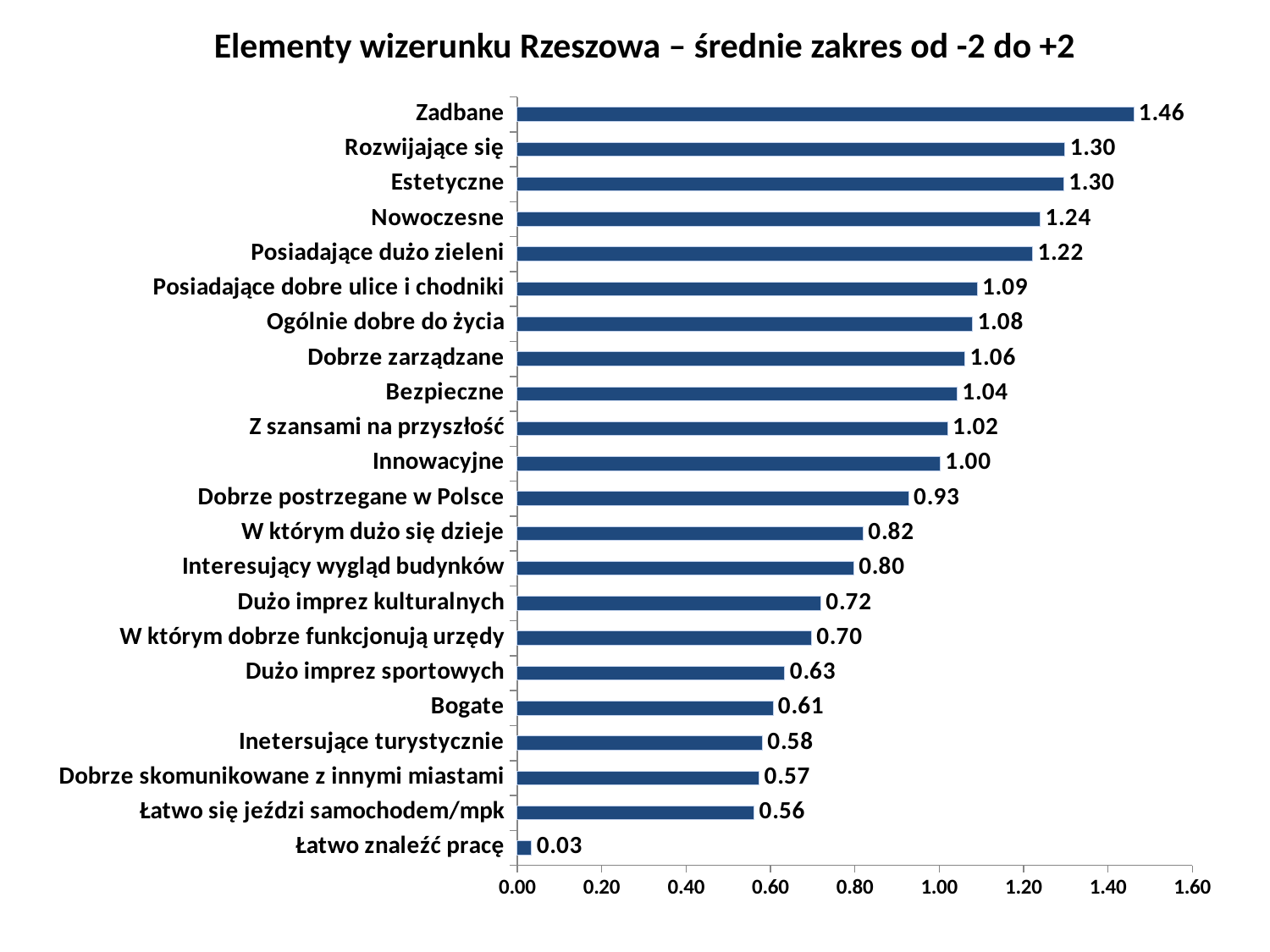
Which is larger, the value for Bezpieczne or the value for Bogate? Bezpieczne What kind of chart is shown on the slide? Bar chart What is the difference between the values for Zadbane and Nowoczesne? 0.22 What is the value for Zadbane? 1.46 Which category has the lowest value? Łatwo znaleźć pracę Is the value for Dobrze postrzegane w Polsce greater or less than 1.00? less What is the value for Dobrze zarządzane? 1.06 What is the value for Dużo imprez sportowych? 0.63 Which category has the highest value? Zadbane How many categories are shown in the chart? 22 What is the value for Łatwo znaleźć pracę? 0.03 What is the title of the chart? Elementy wizerunku Rzeszowa – średnie zakres od -2 do +2